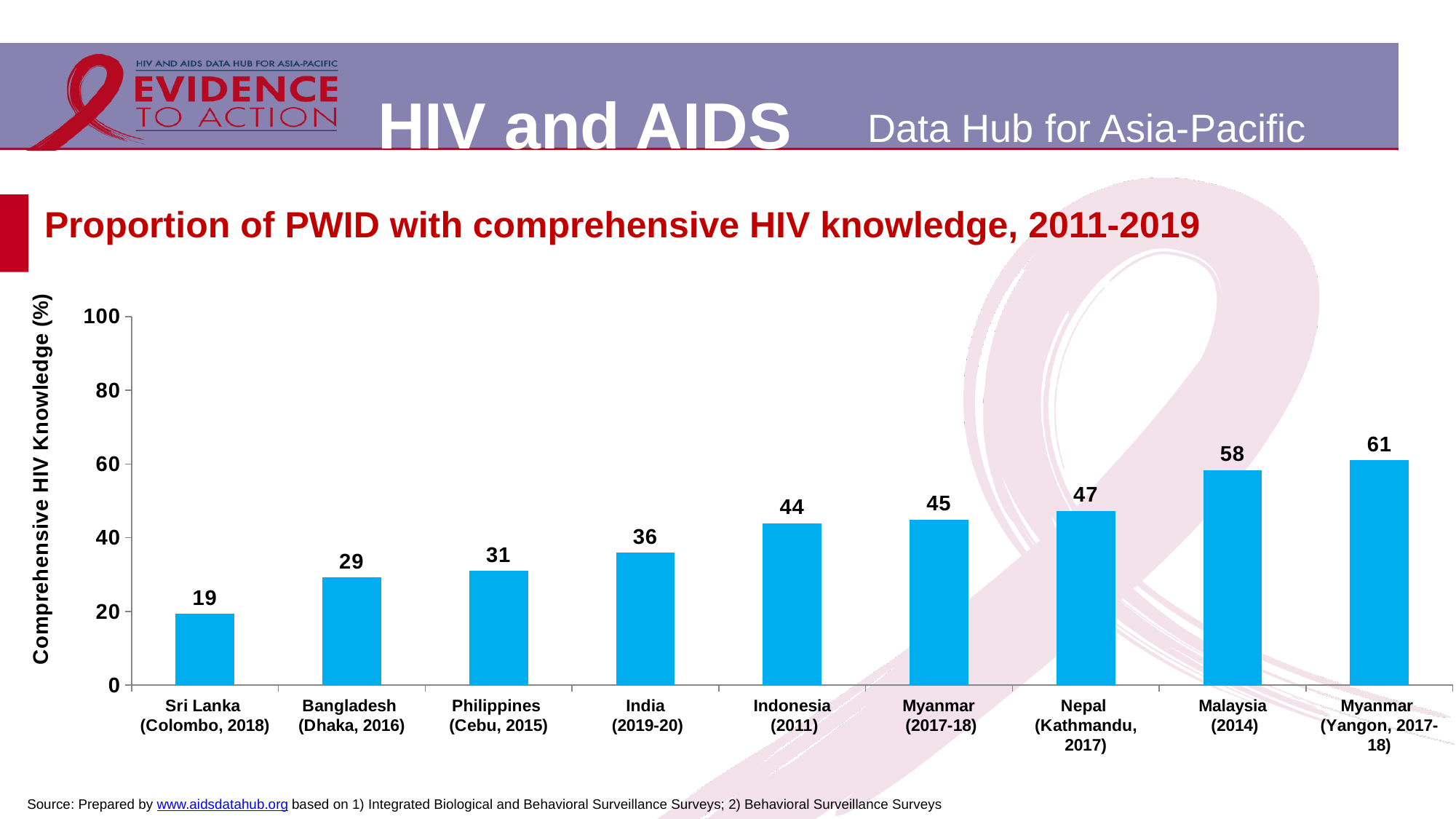
What is the label of the y axis? Comprehensive HIV Knowledge (%) What is the difference between the values for Malaysia (2014) and Bangladesh (Dhaka, 2016)? 29 Is the value for Myanmar (2017-18) greater or less than 40? greater What is the value for Nepal (Kathmandu, 2017)? 47 What kind of chart is shown on the slide? bar chart Which category has the highest value? Myanmar (Yangon, 2017-18) What is the value for Indonesia (2011)? 44 Do the values rise or fall from left to right along the x axis? rise Which category has the lowest value? Sri Lanka (Colombo, 2018) What is the value for Sri Lanka (Colombo, 2018)? 19 Which is larger, the value for India (2019-20) or the value for Philippines (Cebu, 2015)? India (2019-20) How many categories are shown on the x axis? 9